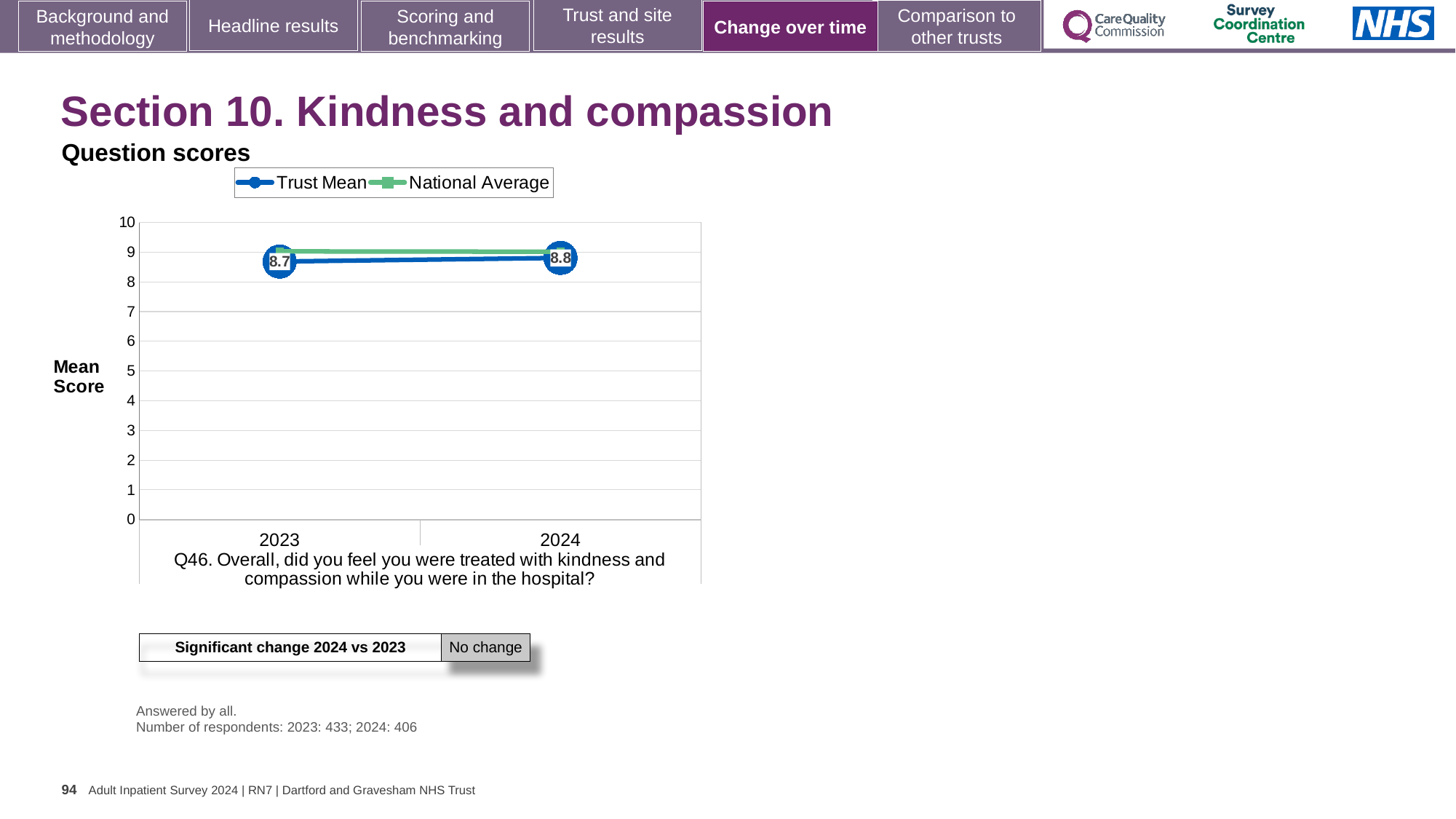
What is the label on the y axis? Mean Score Which is larger, the Trust Mean for 2023 or for 2024? 2024 What is the difference between the Trust Mean scores for 2024 and 2023? 0.1 Does the Trust Mean rise or fall from 2023 to 2024? rise In which year is the Trust Mean score higher? 2024 What is the Trust Mean score for 2024? 8.8 Is the National Average value for 2023 greater or less than 8? greater How many series does the legend list? 2 How many years are plotted on the x axis? 2 What is the Trust Mean score for 2023? 8.7 In which year is the Trust Mean score lower? 2023 What kind of chart is shown? line chart